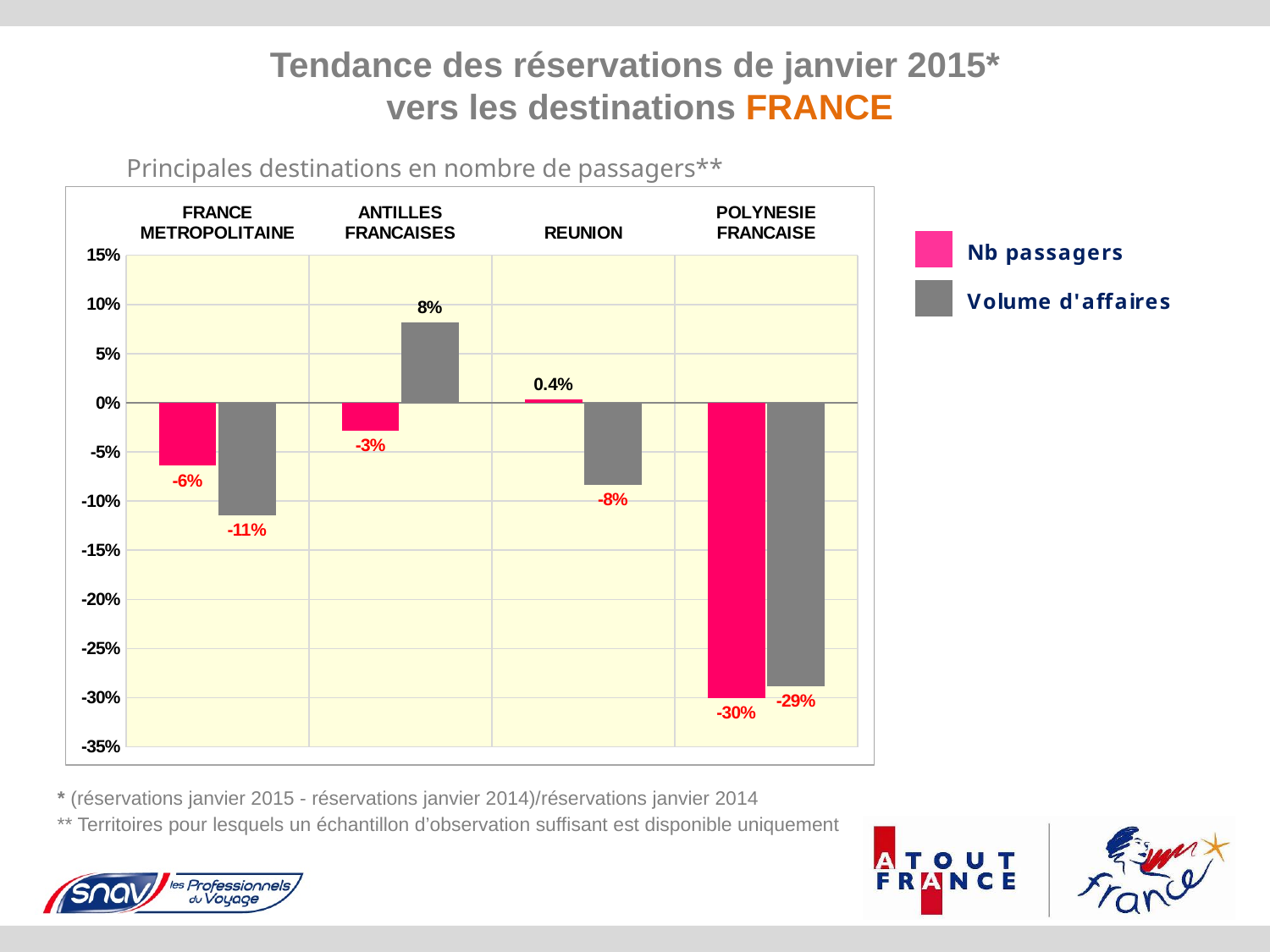
Which destination has the highest Volume d'affaires value? ANTILLES FRANCAISES Which destination has the lowest Nb passagers value? POLYNESIE FRANCAISE How many destinations are shown on the chart? 4 What is the Nb passagers value for FRANCE METROPOLITAINE? -6% What is the Volume d'affaires value for POLYNESIE FRANCAISE? -29% How many series does the legend list? 2 What colour represents the Nb passagers series in the legend? Pink What is the Nb passagers value for REUNION? 0.4% What is the Volume d'affaires value for ANTILLES FRANCAISES? 8% What is the difference between the Volume d'affaires value for ANTILLES FRANCAISES and the Volume d'affaires value for REUNION? 16 percentage points What kind of chart is shown on the slide? Bar chart Which is larger for FRANCE METROPOLITAINE: the Nb passagers value or the Volume d'affaires value? Nb passagers